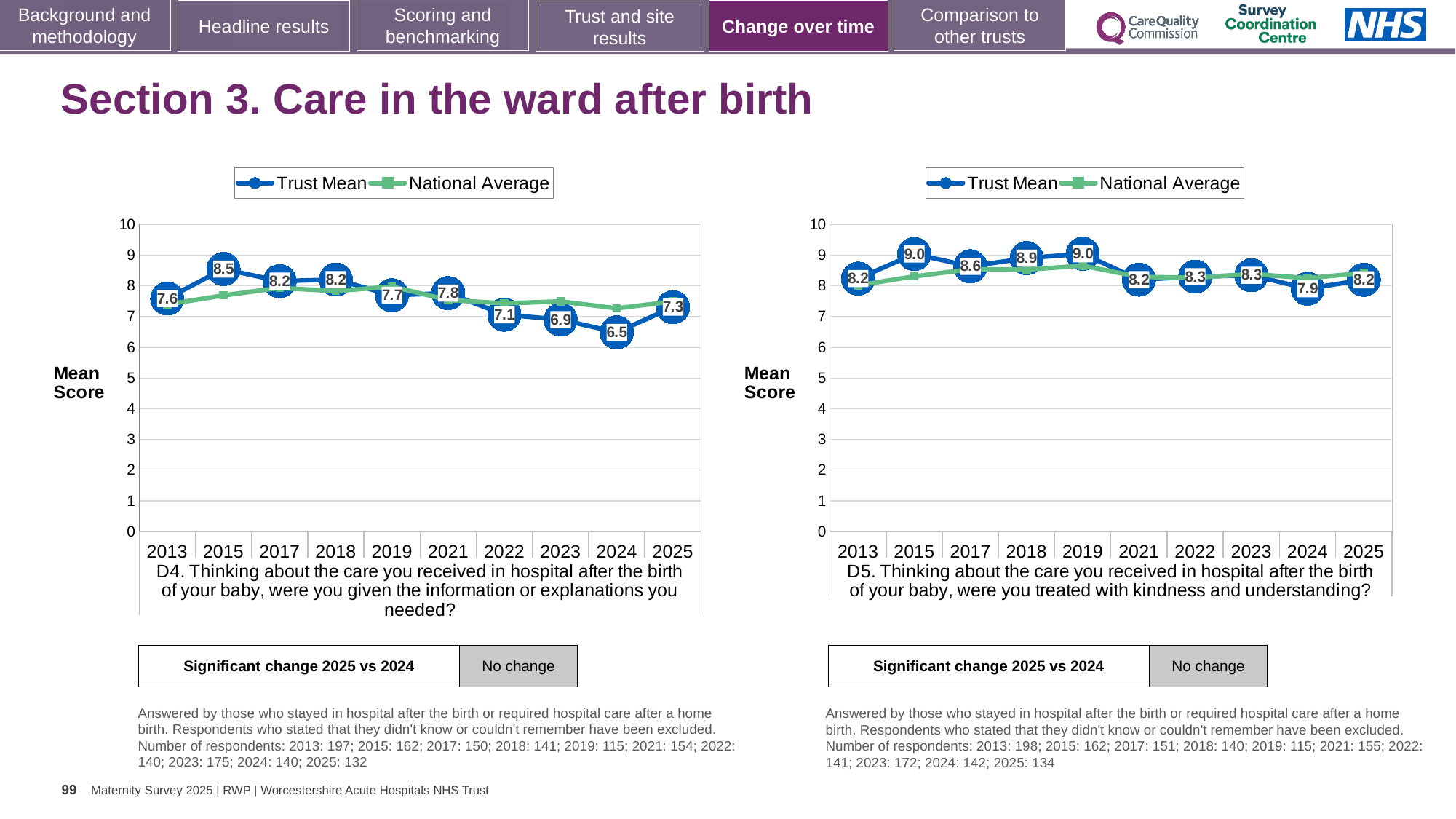
On the D5 chart (right), which year has the lowest Trust Mean score? 2024 On the D5 chart (right), is the National Average value for 2019 greater or less than 8? greater How many series does the legend of the D5 chart (right) list? 2 On the D4 chart (left), which year has the highest Trust Mean score? 2015 On the D5 chart (right), what is the Trust Mean score for 2018? 8.9 On the D4 chart (left), what is the Trust Mean score for 2024? 6.5 On the D5 chart (right), is the Trust Mean score for 2015 or 2017 larger? 2015 On the D4 chart (left), which year has the lowest Trust Mean score? 2024 On the D4 chart (left), what is the Trust Mean score for 2015? 8.5 On the D4 chart (left), what is the difference between the Trust Mean scores for 2025 and 2024? 0.8 How many years are plotted on the D4 chart (left)? 10 What kind of chart is the D4 chart (left)? Line chart